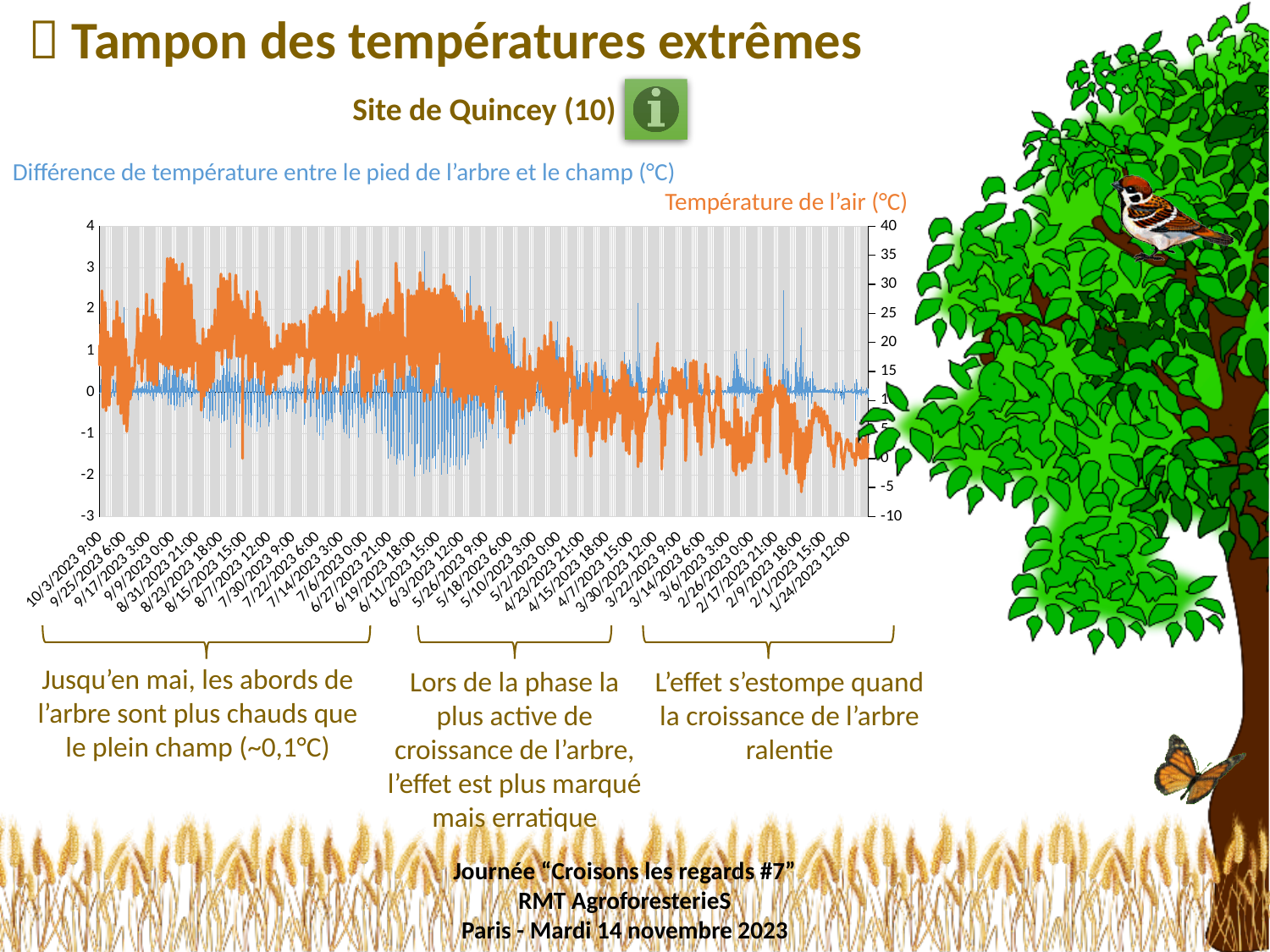
What is the highest value shown on the left vertical axis? 4 Does the air temperature (orange series) generally rise or fall from the left to the right of the x axis? fall What is the first date label on the left of the x axis? 10/3/2023 9:00 What is the highest value shown on the right vertical axis? 40 Is the peak air temperature around 9/9/2023 greater or less than 25 on the right axis? greater Is the air temperature around 1/24/2023 greater or less than 10 on the right axis? less Which colour is used for the temperature difference series (Différence de température entre le pied de l'arbre et le champ)? blue What is the last date label on the right of the x axis? 1/24/2023 12:00 Which colour is used for the air temperature series (Température de l'air)? orange How many data series are plotted on the chart? 2 What kind of chart is shown on the slide? line chart What is the lowest value shown on the right vertical axis? -10